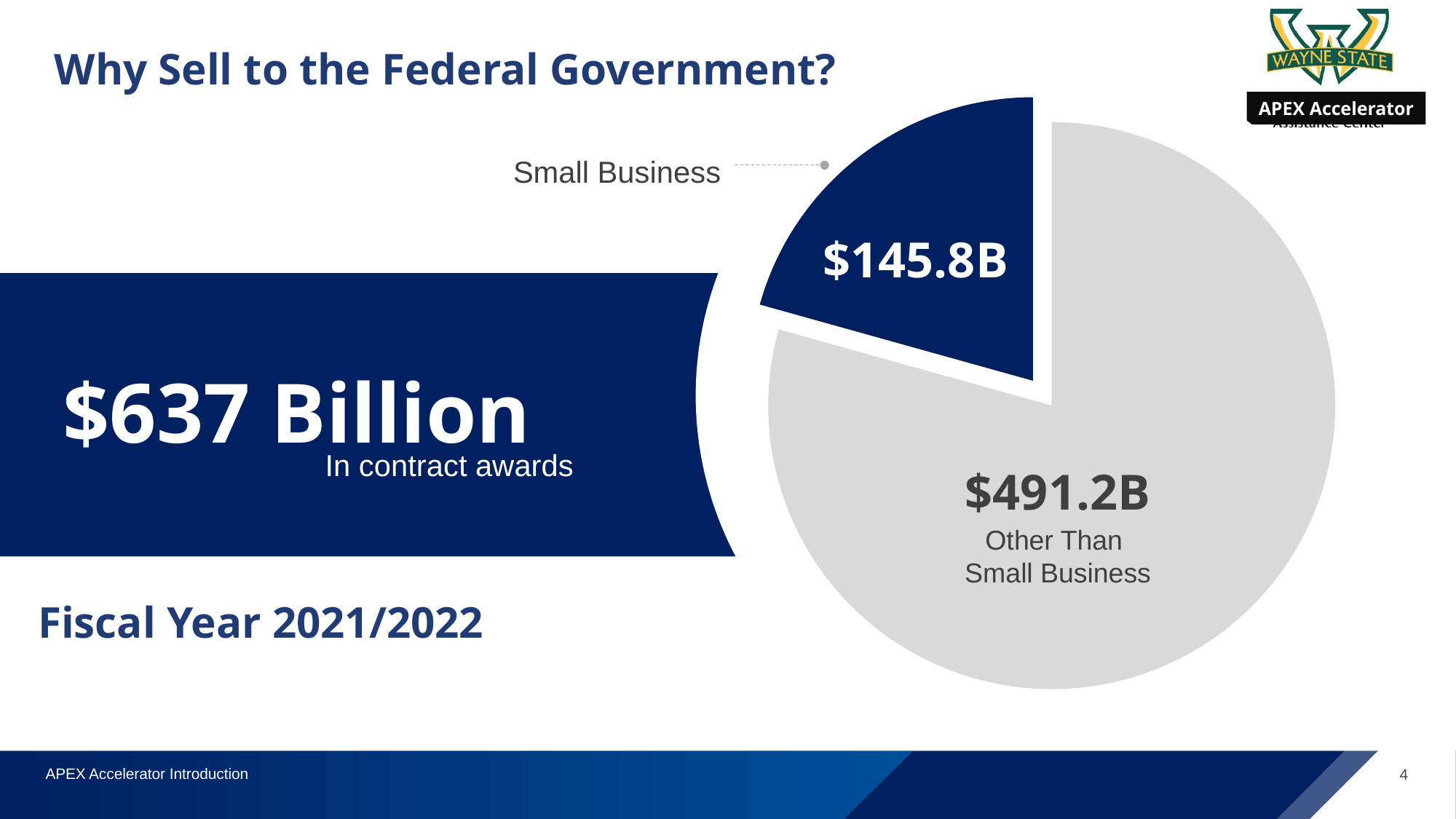
Which slice of the pie chart is the smallest? Small Business Which slice of the pie chart is the largest? Other Than Small Business What is the value of the Other Than Small Business slice in the pie chart? $491.2B Which is larger in the pie chart, Small Business or Other Than Small Business? Other Than Small Business Which fiscal year does the slide's data refer to? Fiscal Year 2021/2022 How many slices does the pie chart have? 2 What type of chart is shown on the slide? pie chart What is the difference between the Other Than Small Business value and the Small Business value in the pie chart? $345.4B What is the total of the two slices in the pie chart? $637B What colour is the Small Business slice in the pie chart? dark blue What total contract award amount is stated on the slide? $637 Billion What is the value of the Small Business slice in the pie chart? $145.8B